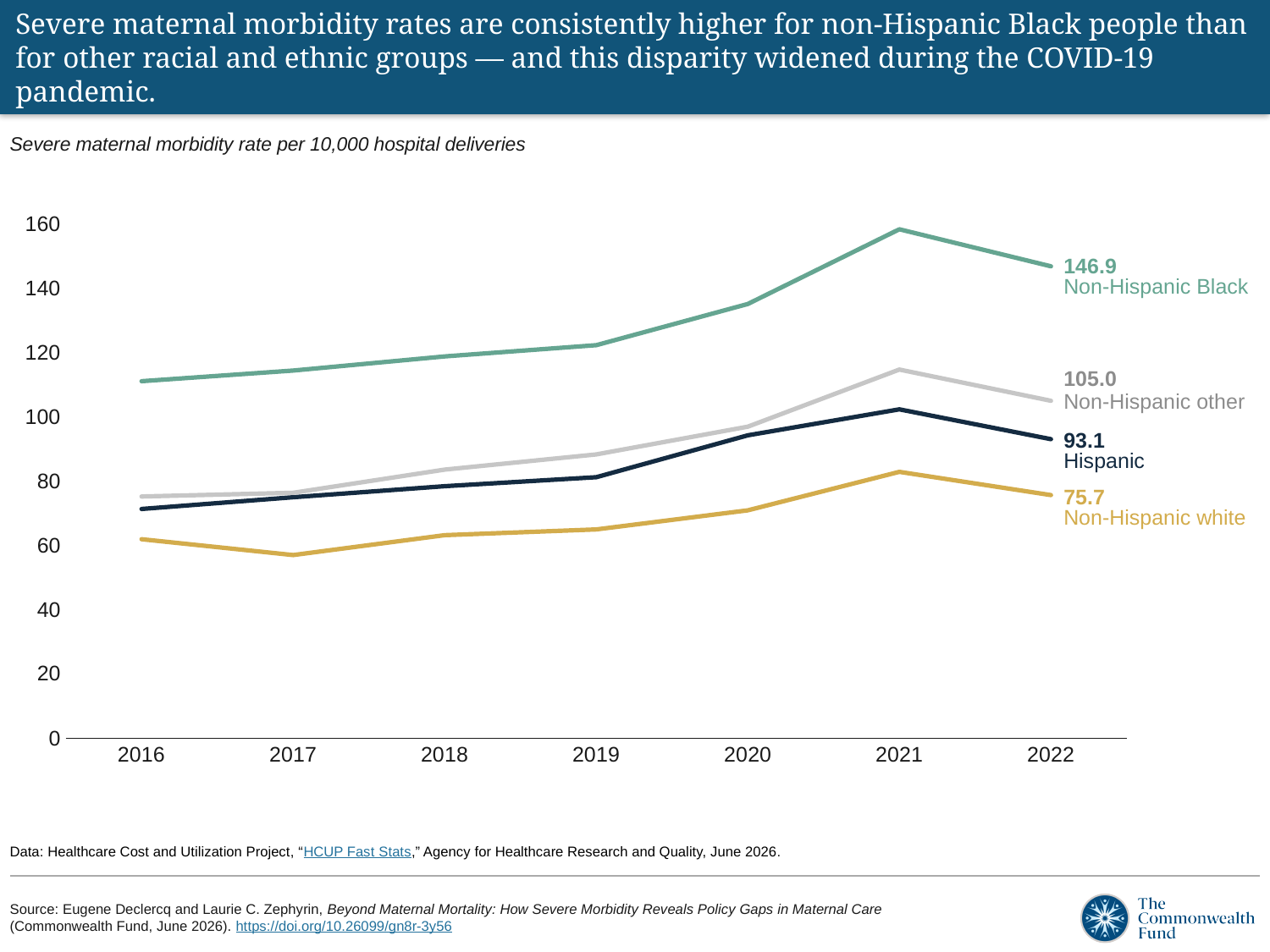
How many years are shown on the x axis? 7 Which group has the lowest severe maternal morbidity rate in 2022? Non-Hispanic white What type of chart is shown on the slide? Line chart What is the 2022 value for the Hispanic line? 93.1 Which group has the highest severe maternal morbidity rate in 2022? Non-Hispanic Black What is the difference between the 2022 rates for Non-Hispanic Black and Non-Hispanic white people? 71.2 What is the 2022 value for the Non-Hispanic white line? 75.7 What is the severe maternal morbidity rate for Non-Hispanic Black people in 2022? 146.9 In 2022, which is larger: the rate for Hispanic people or for Non-Hispanic other people? Non-Hispanic other Is the value for Non-Hispanic white people in 2017 greater or less than 60? less How many lines (series) are plotted on the chart? 4 Is the value for Non-Hispanic Black people in 2021 greater or less than 140? greater